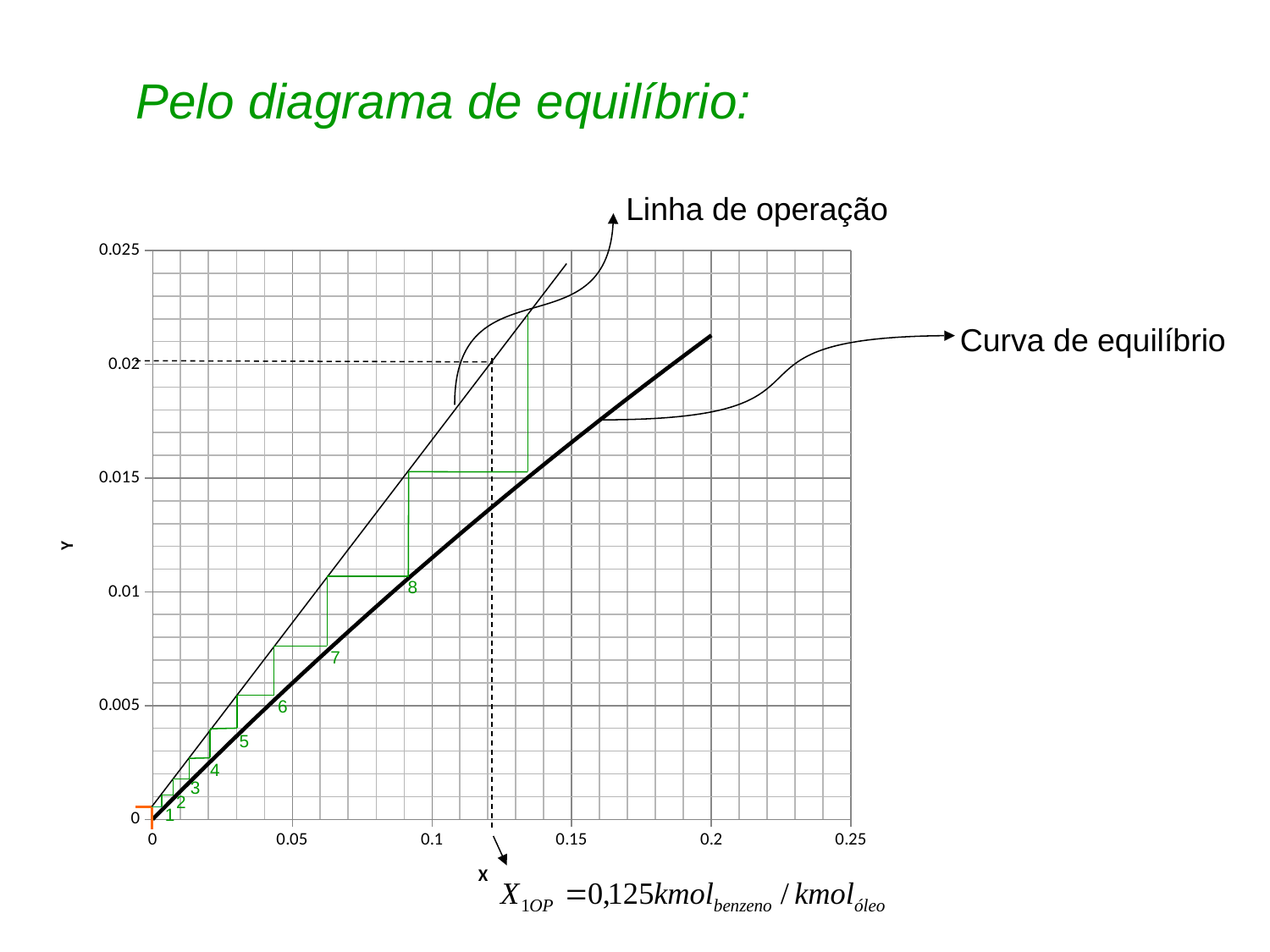
How many numbered stages (steps) are drawn between the operating line and the equilibrium curve? 8 At which Y value does the horizontal dashed line meet the Y axis? 0.02 Is the value of the equilibrium curve at X = 0.2 greater or less than 0.02? greater What are the two curves labelled on the chart? Linha de operação and Curva de equilíbrio What kind of chart is shown on the slide? line chart What value of X_1OP is given below the chart? 0,125 kmol benzeno / kmol óleo Do the values of the equilibrium curve rise or fall as X increases? rise What is the maximum value shown on the X axis? 0.25 Is the value of the operating line at X = 0.1 greater or less than 0.015? greater Is the value of the equilibrium curve at X = 0.05 greater or less than 0.01? less At X = 0.1, which is higher: the operating line (Linha de operação) or the equilibrium curve (Curva de equilíbrio)? Linha de operação What is the maximum value shown on the Y axis? 0.025